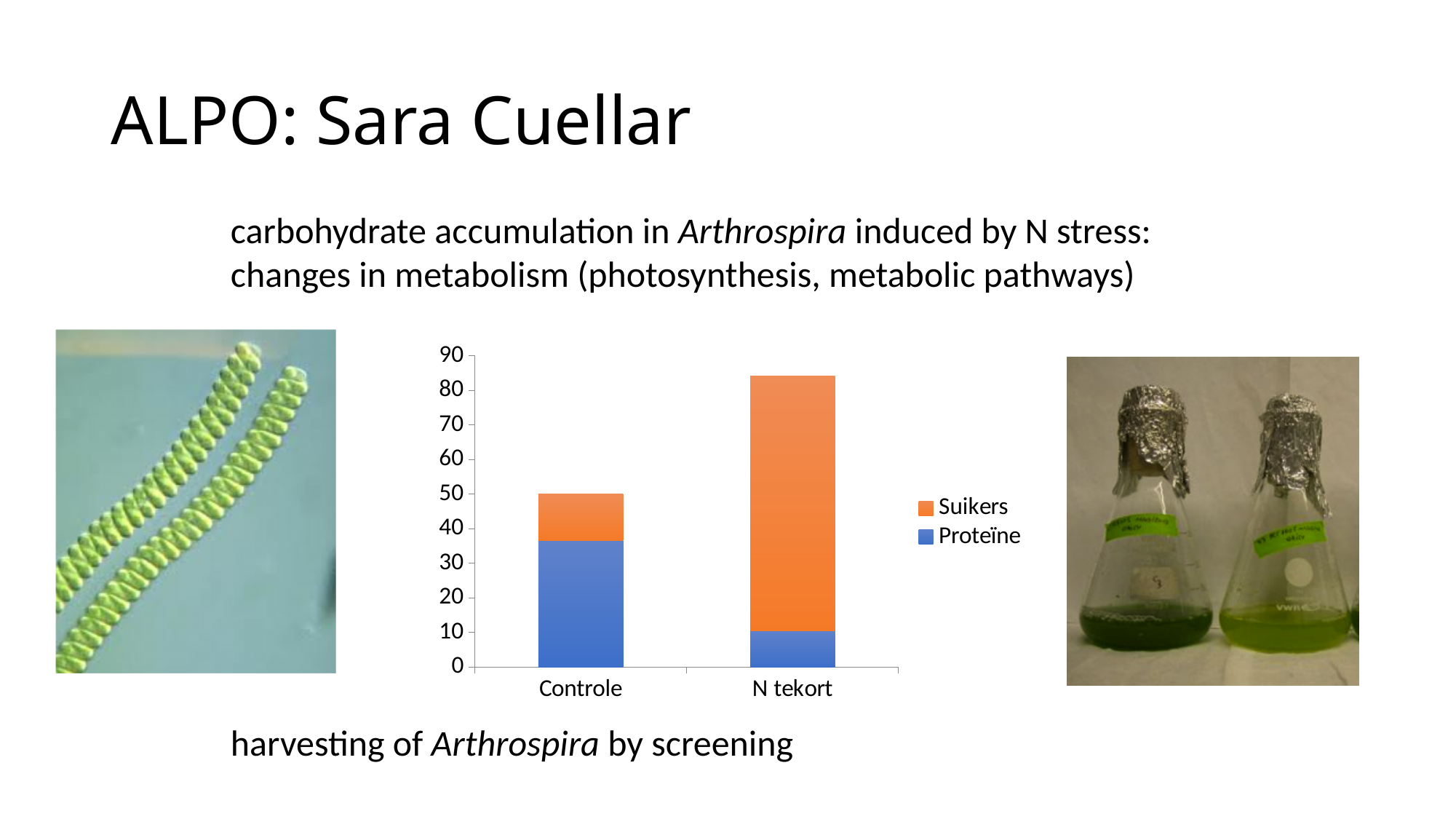
Which colour represents Suikers in the chart? orange Is the Proteïne value for N tekort greater or less than 20? less Is the Proteïne value for Controle greater or less than 30? greater Is the Proteïne value larger for Controle or for N tekort? Controle How many categories are shown on the x axis of the chart? 2 Is the Suikers portion of the Controle bar greater or less than 20? less What are the two series named in the chart's legend? Suikers and Proteïne What kind of chart is shown on the slide? bar chart How many series does the chart's legend list? 2 Which category has the taller stacked bar, Controle or N tekort? N tekort Which series makes up the larger part of the N tekort bar? Suikers